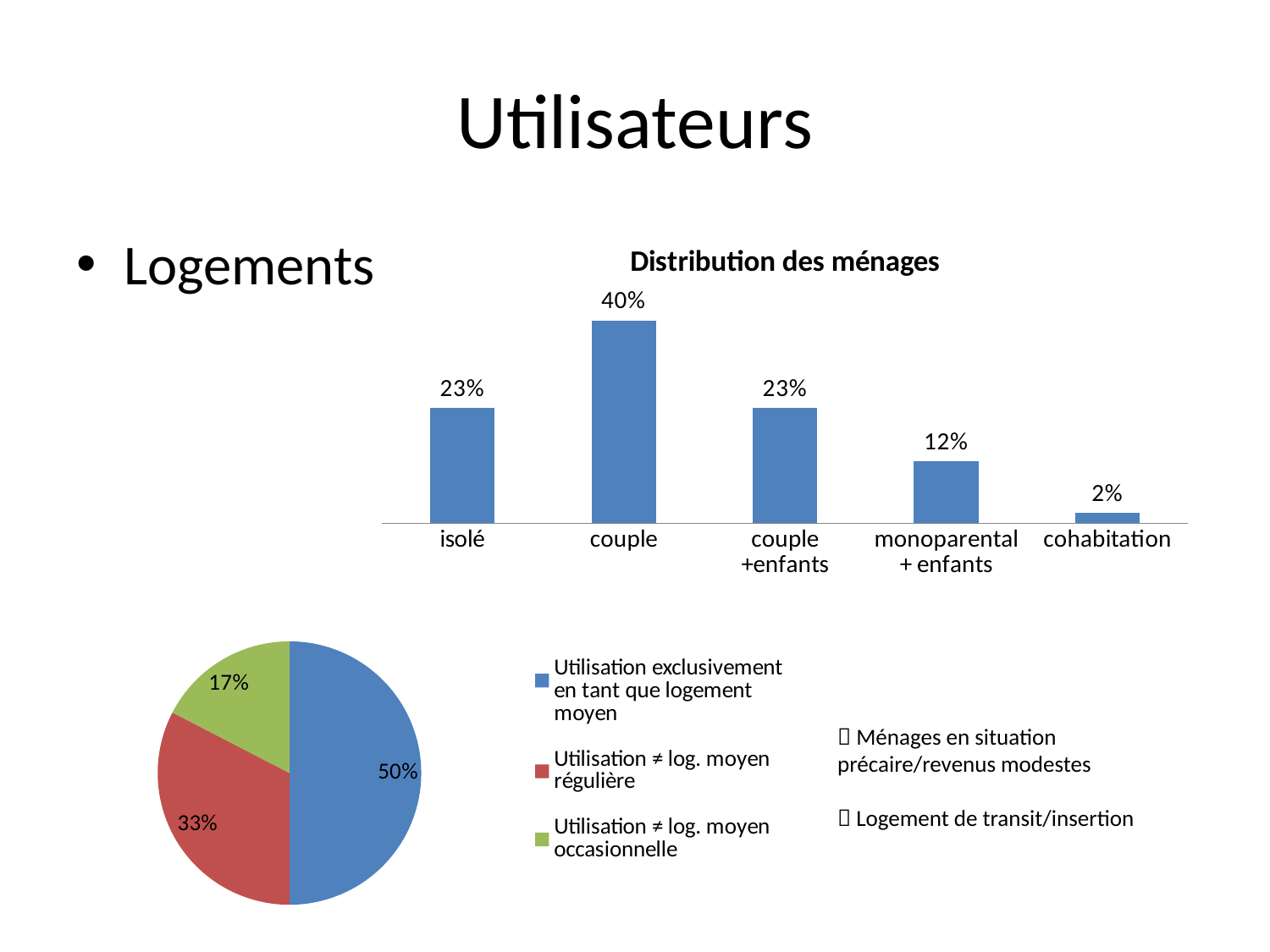
What kind of chart is 'Distribution des ménages'? bar chart In the pie chart at the bottom left, what share does 'Utilisation ≠ log. moyen occasionnelle' have? 17% How many entries does the legend of the pie chart at the bottom left list? 3 In the pie chart at the bottom left, what share does 'Utilisation exclusivement en tant que logement moyen' have? 50% How many categories are shown in the 'Distribution des ménages' chart? 5 In the pie chart at the bottom left, which colour is the slice for 'Utilisation ≠ log. moyen régulière'? red In the 'Distribution des ménages' chart, which category has the lowest value? cohabitation In the 'Distribution des ménages' chart, what is the difference between the values for couple and isolé? 17% In the 'Distribution des ménages' chart, which is larger, the value for couple +enfants or the value for monoparental + enfants? couple +enfants In the 'Distribution des ménages' chart, what is the value for monoparental + enfants? 12% In the 'Distribution des ménages' chart, what is the value for couple? 40% In the 'Distribution des ménages' chart, which category has the highest value? couple